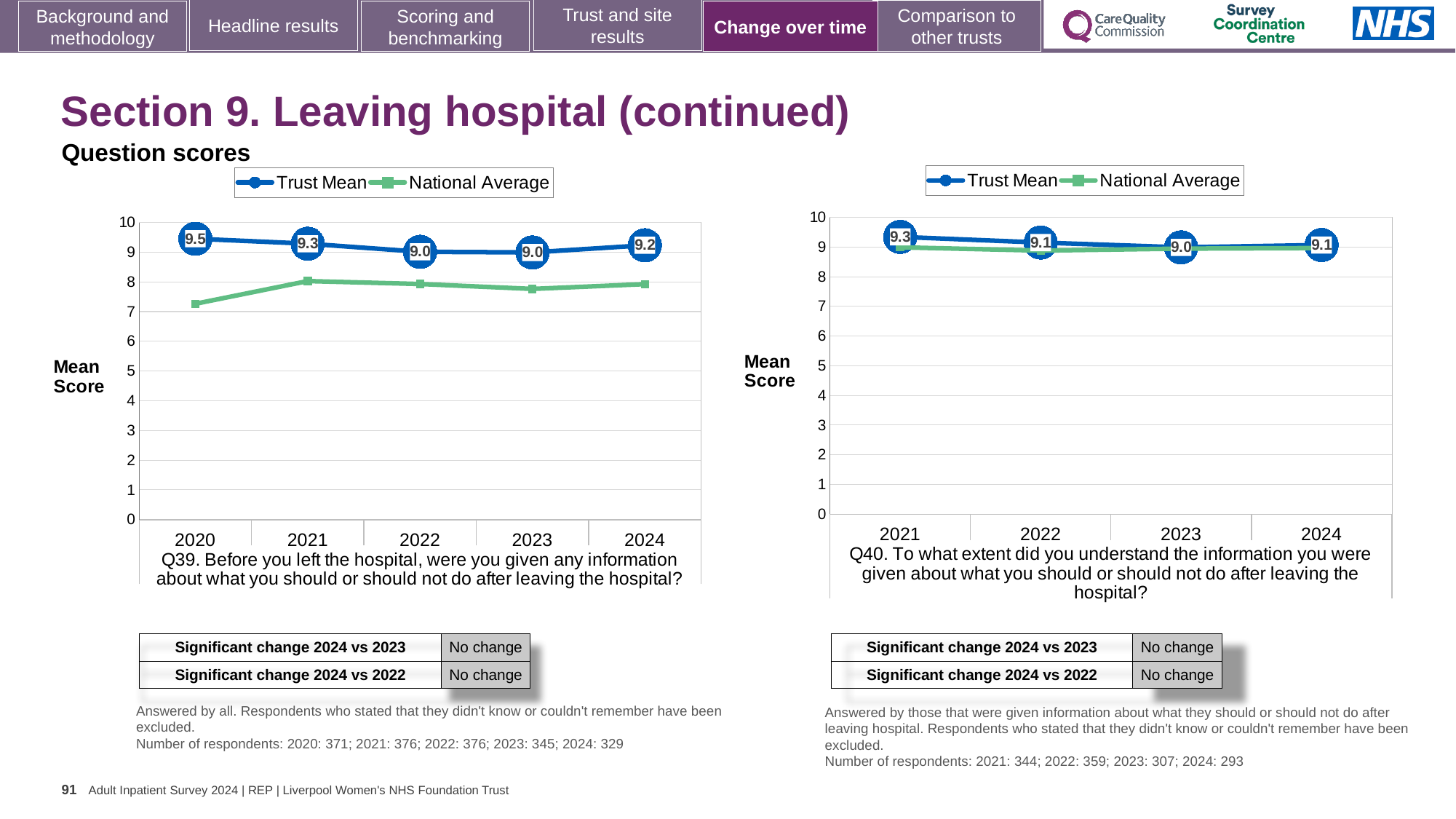
In the Q40 chart on the right, what is the Trust Mean score for 2023? 9.0 In the Q40 chart on the right, which year has the lowest Trust Mean score? 2023 How many years are shown on the x axis of the Q39 chart on the left? 5 How many series does the legend of the Q40 chart on the right list? 2 In the Q39 chart on the left, which year has the highest Trust Mean score? 2020 In the Q39 chart on the left, what is the difference between the Trust Mean scores for 2020 and 2024? 0.3 In the Q39 chart on the left, does the Trust Mean score rise or fall from 2020 to 2022? Fall What type of chart is the Q39 chart on the left? Line chart In the Q39 chart on the left, what is the Trust Mean score for 2020? 9.5 In the Q40 chart on the right, which is larger, the Trust Mean score for 2021 or for 2024? 2021 In the Q39 chart on the left, is the National Average value for 2020 greater or less than 8? less In the Q39 chart on the left, what is the Trust Mean score for 2024? 9.2